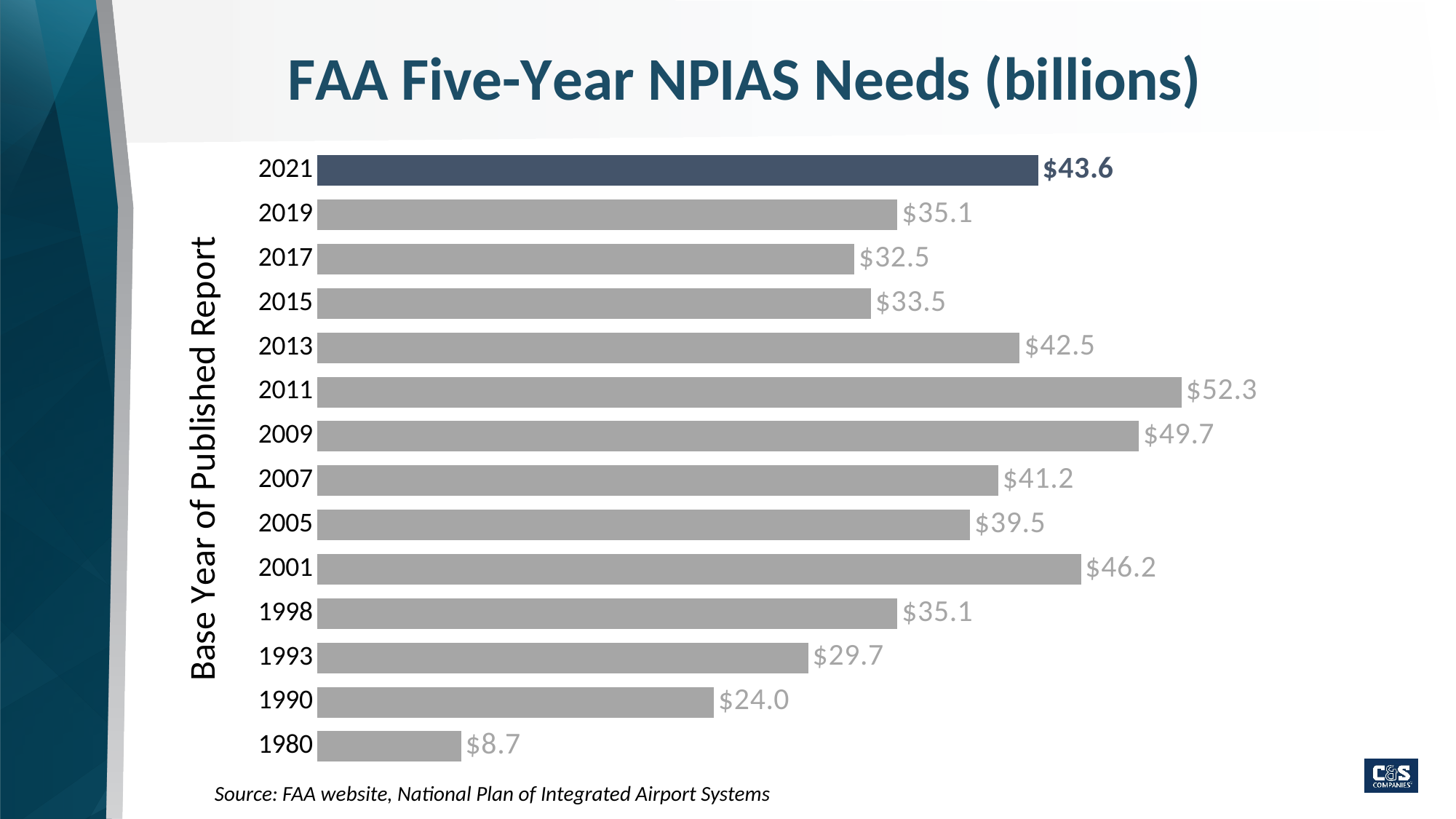
How many base years are shown in the chart? 14 What is the value for 2009? $49.7 What kind of chart is shown on the slide? bar chart What is the value for 1980? $8.7 What is the title of the chart? FAA Five-Year NPIAS Needs (billions) Which base year has the highest value? 2011 What is the difference between the values for 2011 and 1980? $43.6 What is the difference between the values for 2021 and 2019? $8.5 Which is larger, the value for 2013 or the value for 2015? 2013 What is the value for 2021? $43.6 Which base year has the lowest value? 1980 What is the label of the vertical axis? Base Year of Published Report